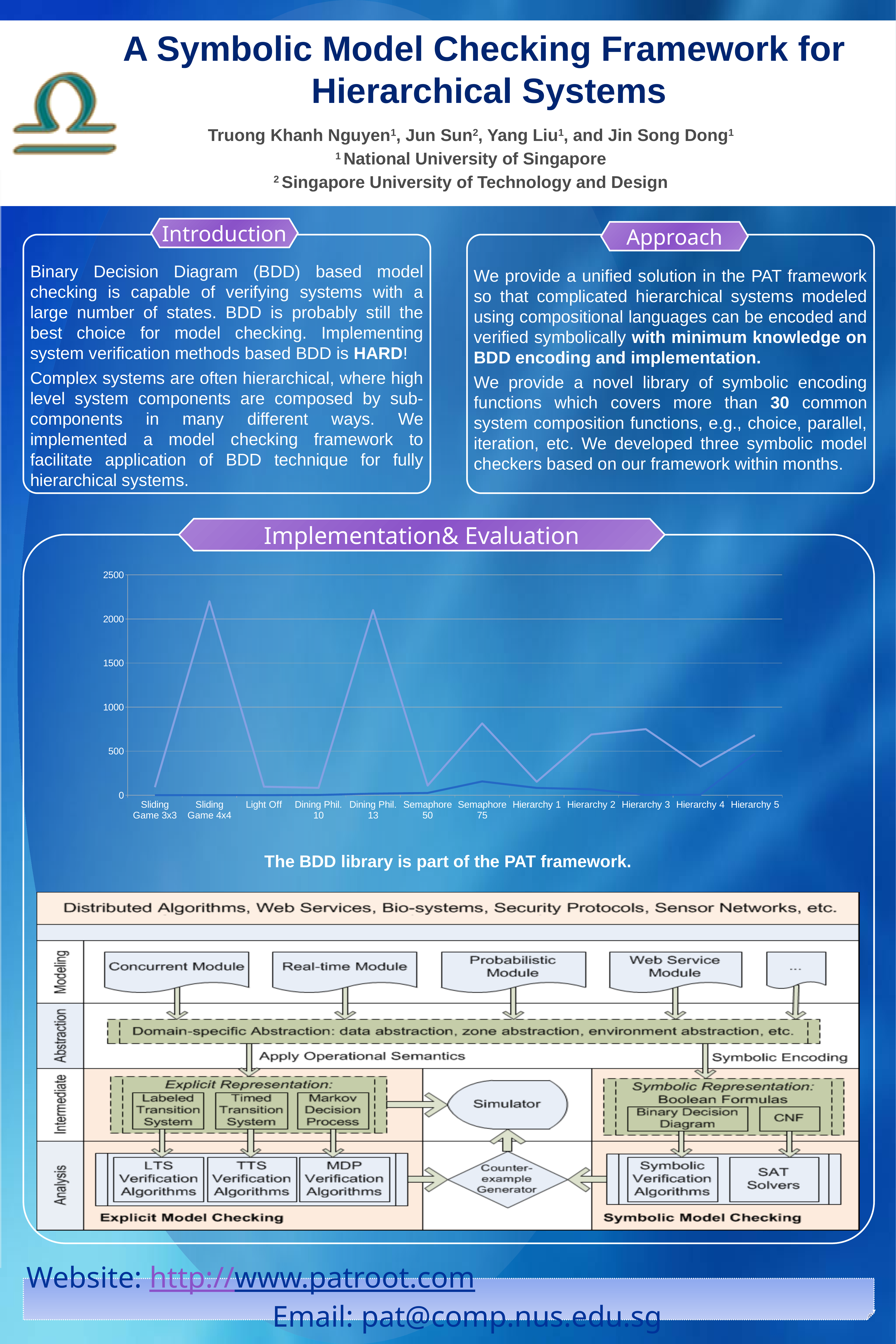
On the light purple line, which is larger, the value for Semaphore 75 or the value for Semaphore 50? Semaphore 75 What is the highest value shown on the y axis of the line chart? 2500 On the light purple line, is the value for Semaphore 75 greater or less than 500? greater On the light purple line, is the value for Sliding Game 4x4 greater or less than 2000? greater What kind of chart is shown in the Implementation & Evaluation section? line chart On the dark blue line, is the value for Semaphore 75 greater or less than 500? less How many lines are plotted on the line chart? 2 On the light purple line, which is larger, the value for Sliding Game 4x4 or the value for Light Off? Sliding Game 4x4 On the light purple line, do the values rise or fall from Hierarchy 1 to Hierarchy 3? rise How many categories are shown along the x axis of the line chart? 12